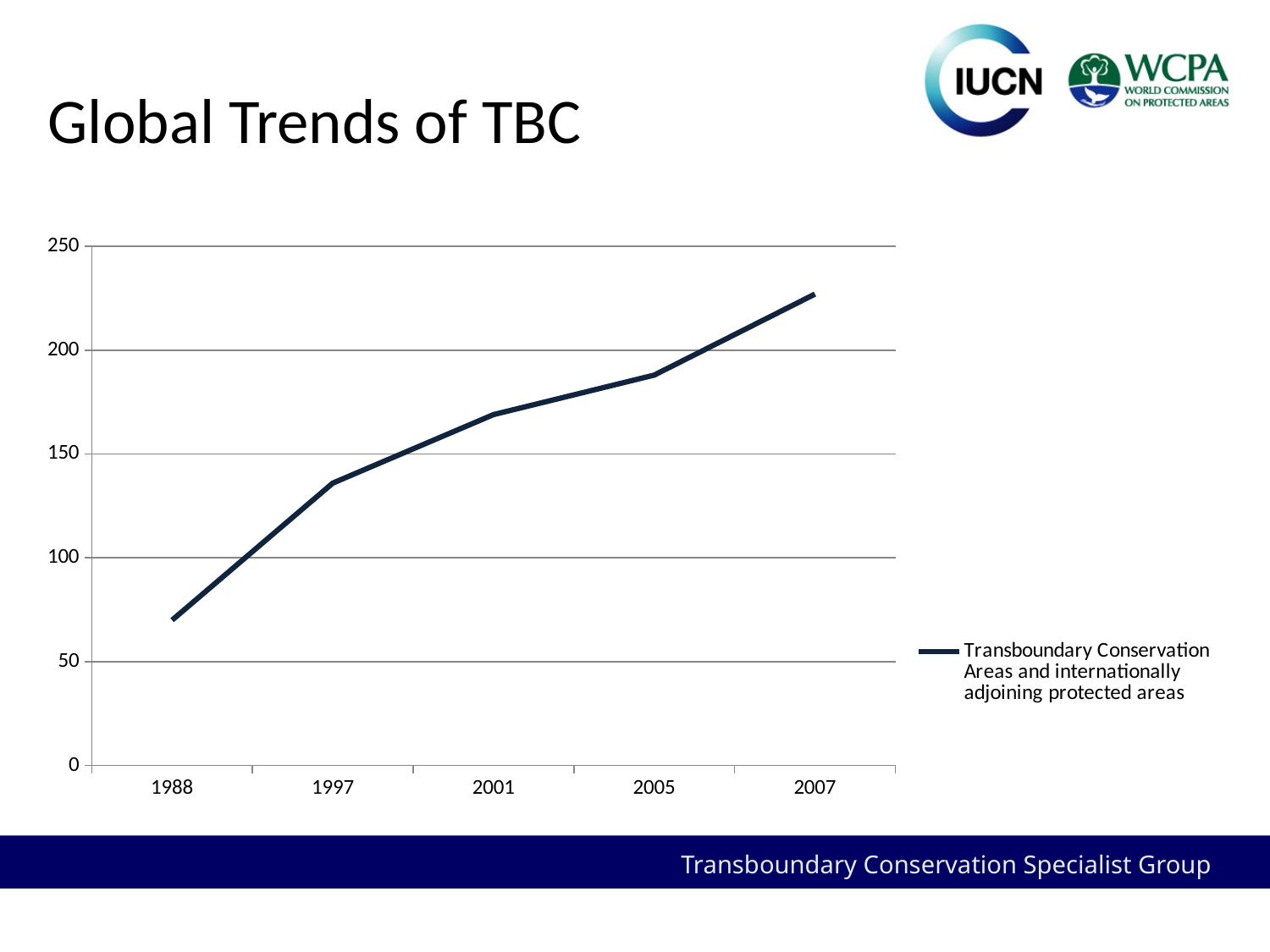
Which year has the lowest value? 1988 Which year has the larger value, 2005 or 2001? 2005 Is the value for 1997 greater or less than 150? less How many series does the legend list? 1 What is the title of the slide containing the chart? Global Trends of TBC Is the value for 2007 greater or less than 200? greater Do the values rise or fall from 1988 to 2007? Rise Is the value for 1988 greater or less than 100? less What kind of chart is shown on the slide? Line chart How many data points are plotted on the line? 5 Which year has the highest value? 2007